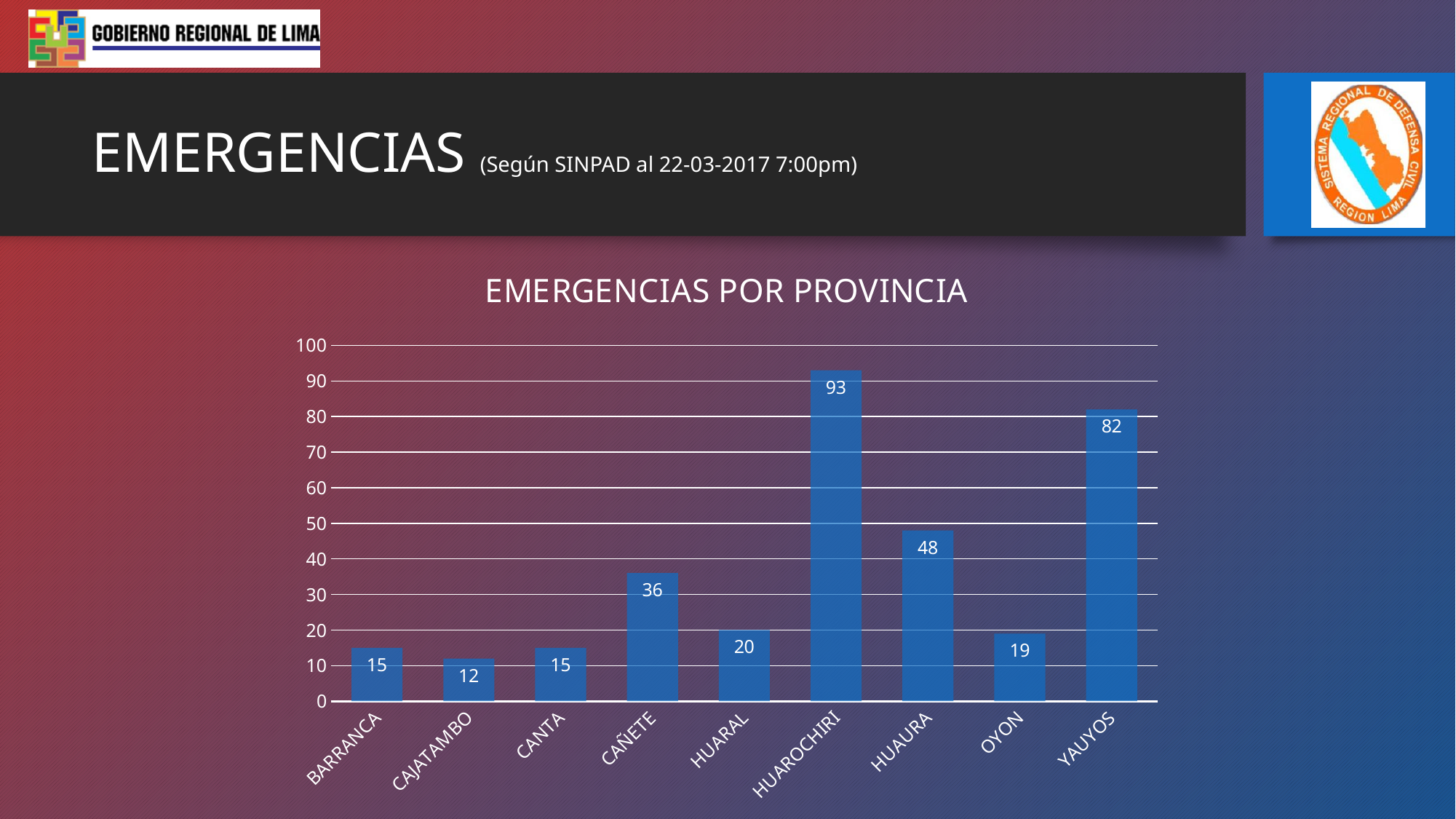
How many provinces are shown on the x axis? 9 What is the title of the chart? EMERGENCIAS POR PROVINCIA Is the value for HUAURA greater or less than 40? greater What is the difference between the values for HUAROCHIRI and YAUYOS? 11 What is the value for YAUYOS? 82 Which province has the lowest number of emergencies? CAJATAMBO What is the difference between the values for HUAURA and CAÑETE? 12 What is the value for CAJATAMBO? 12 Which is larger, the value for HUARAL or the value for OYON? HUARAL Which province has the highest number of emergencies? HUAROCHIRI What kind of chart is shown on the slide? bar chart What is the value for HUAROCHIRI? 93